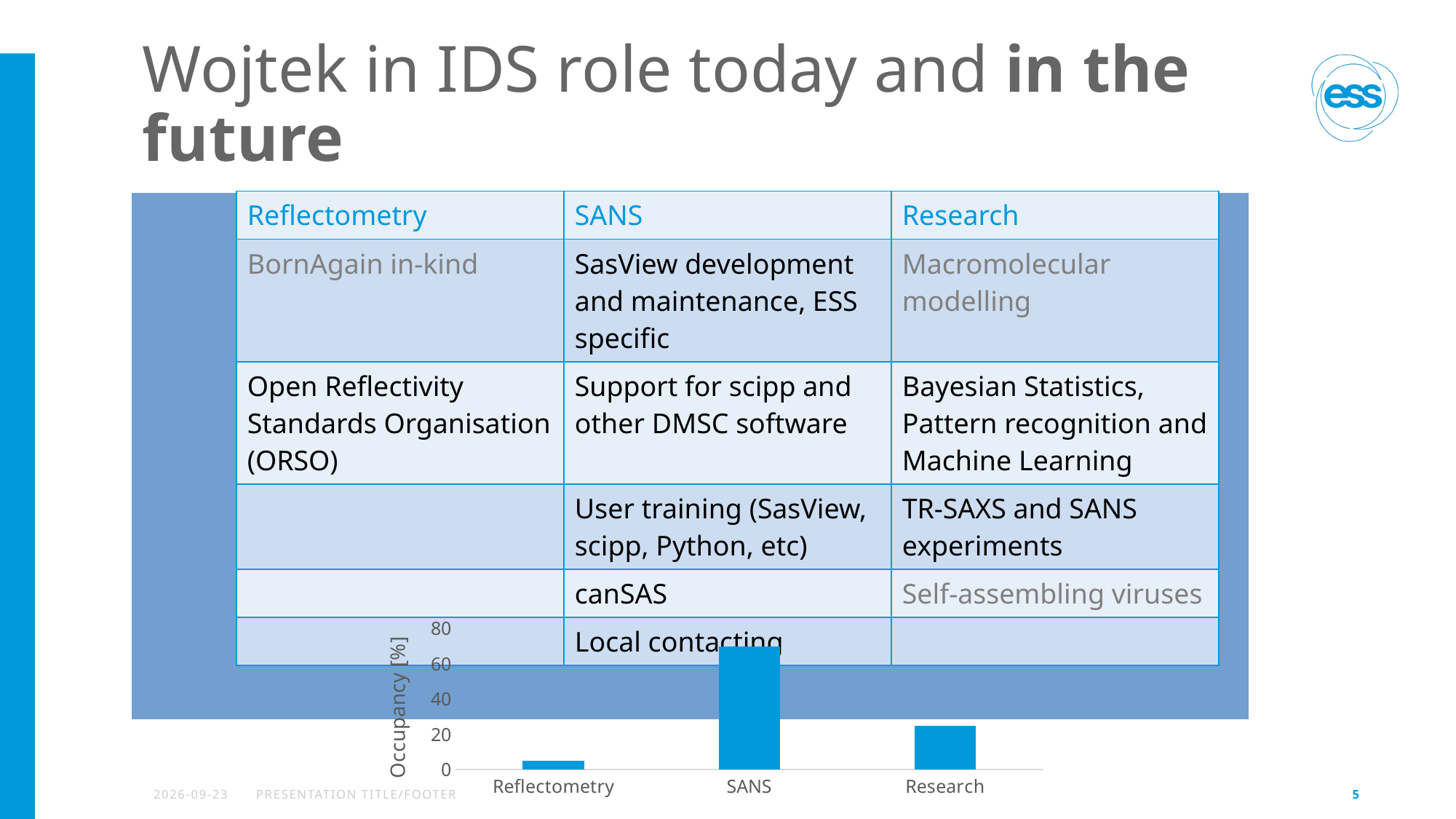
What kind of chart is shown at the bottom of the slide? bar chart Is the occupancy value for Reflectometry greater or less than 20? less Which category has the lowest occupancy in the chart? Reflectometry Which has a larger occupancy value, SANS or Research? SANS What is the label of the vertical axis of the chart? Occupancy [%] Which has a larger occupancy value, Research or Reflectometry? Research Is the occupancy value for SANS greater or less than 40? greater Is the occupancy value for SANS greater or less than 60? greater How many categories are plotted on the x axis of the chart? 3 Which category has the highest occupancy in the chart? SANS What is the highest tick value shown on the vertical axis of the chart? 80